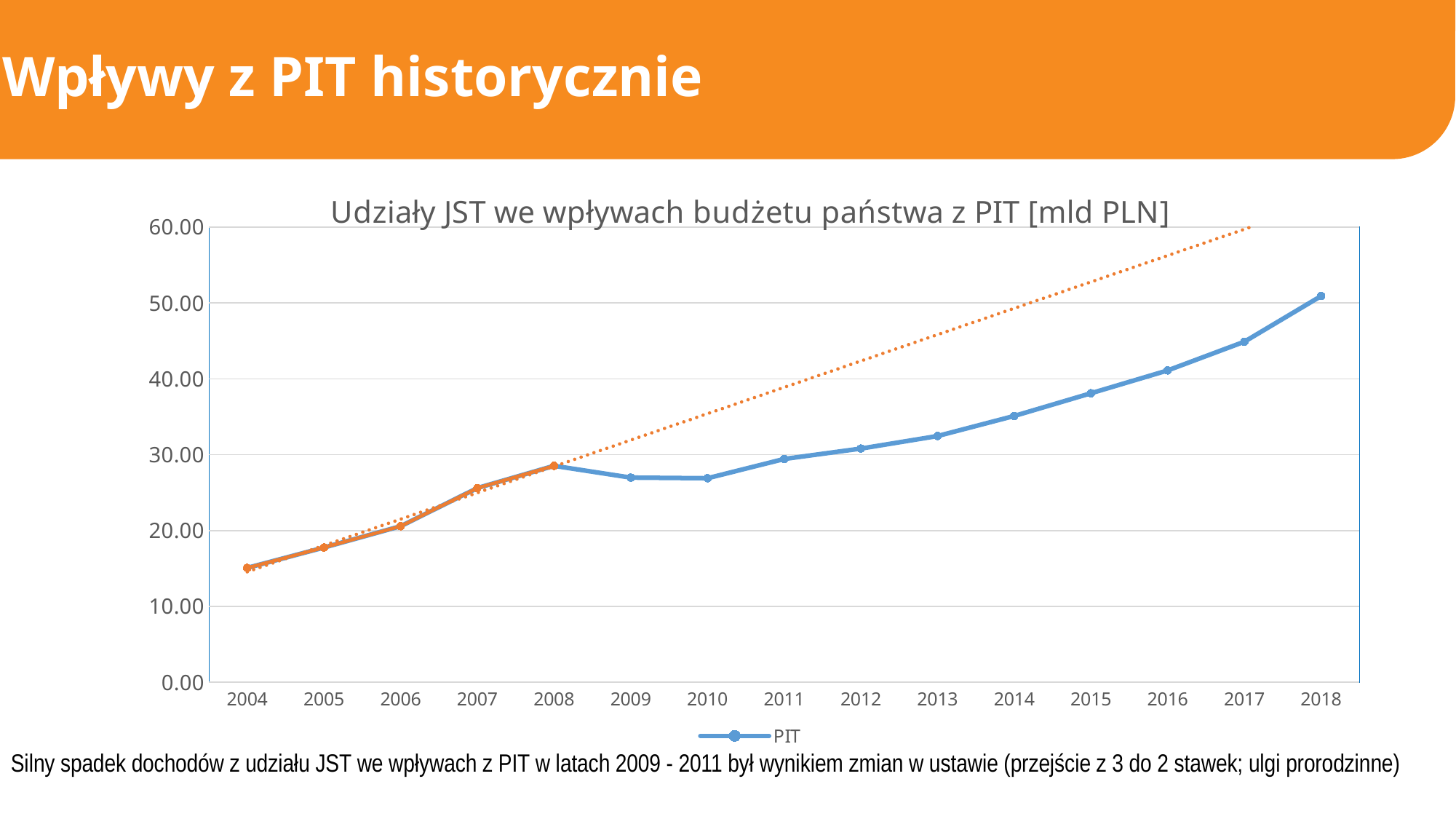
Is the value for PIT in 2014 greater or less than 30.00? greater Which year has the lowest value for PIT? 2004 Is the value for PIT in 2017 greater or less than 40.00? greater What is the title of the chart? Udziały JST we wpływach budżetu państwa z PIT [mld PLN] How many years are plotted on the x axis? 15 Which year has the larger PIT value, 2012 or 2015? 2015 Is the value for PIT in 2010 greater or less than 30.00? less Which year has the highest value for PIT? 2018 What kind of chart is shown on the slide? line chart How many series does the legend list? 1 Does the PIT value rise or fall from 2008 to 2010? fall